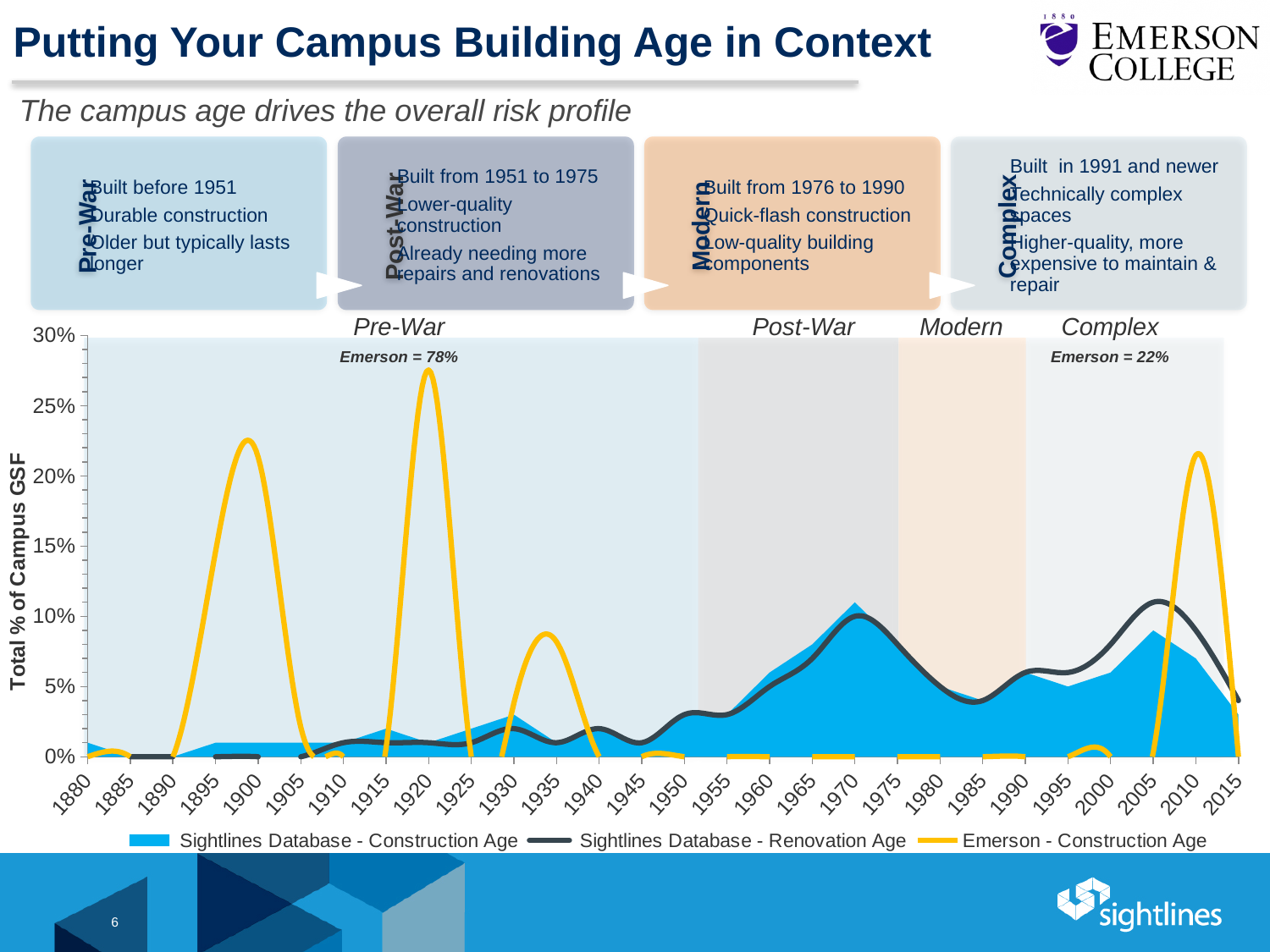
Which is higher: the Emerson - Construction Age peak around 1920 or the Sightlines Database - Construction Age peak around 1970? Emerson - Construction Age peak around 1920 What percentage is given for Emerson in the Pre-War section of the chart? 78% Is the peak of the Emerson - Construction Age series around 1920 greater or less than 25%? greater What kind of chart is shown on the slide? combination area and line chart What percentage is given for Emerson in the Complex section of the chart? 22% What is the title of the chart's vertical axis? Total % of Campus GSF Around which year does the Emerson - Construction Age series reach its highest peak? 1920 How many series does the chart legend list? 3 Is the peak of the Emerson - Construction Age series around 1935 greater or less than 10%? less How many building-age eras (shaded bands) are labelled across the top of the chart? 4 Which series is drawn in yellow according to the legend? Emerson - Construction Age Is the Sightlines Database - Renovation Age value around 1985 greater or less than 5%? less